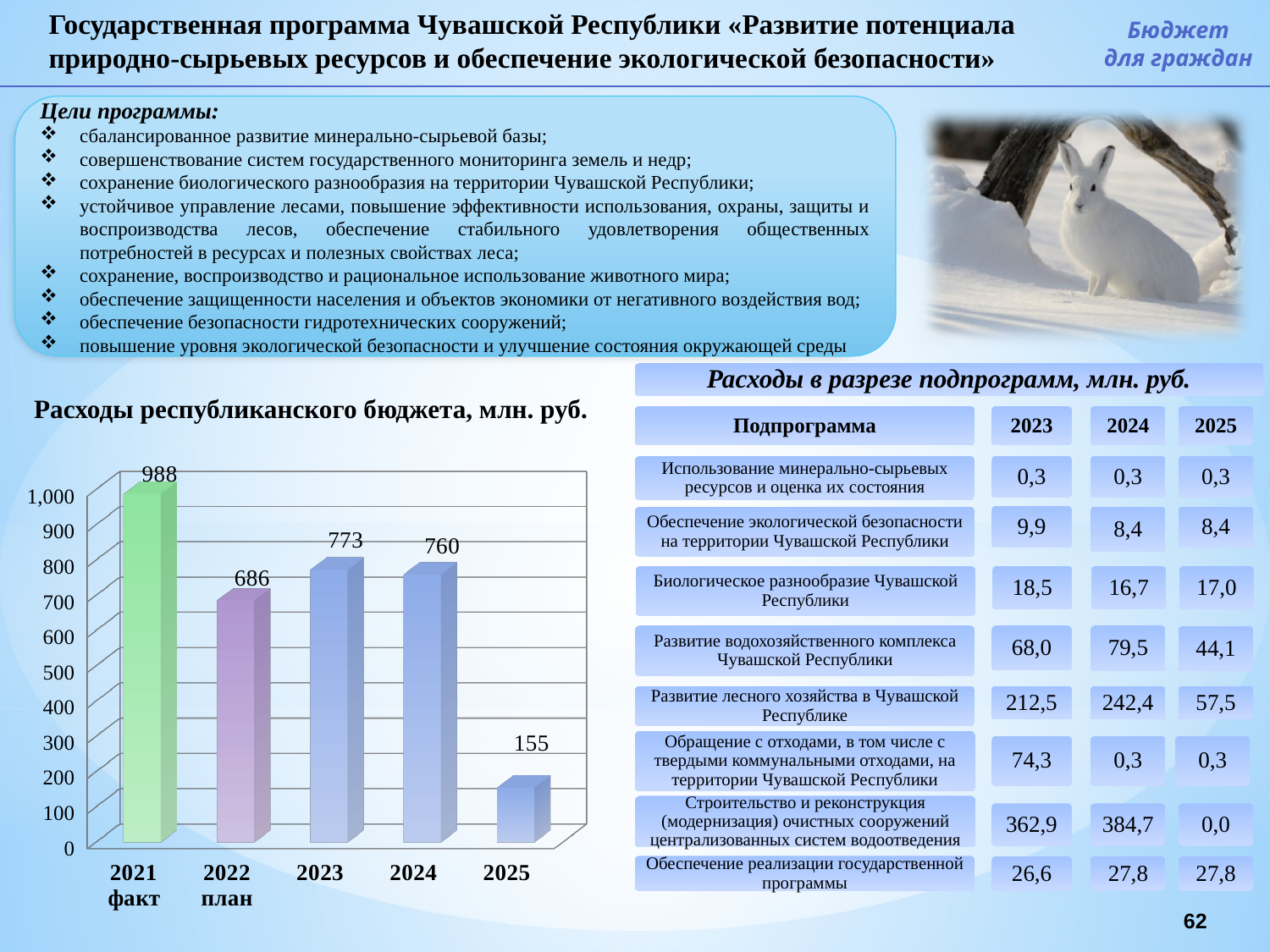
What is the difference between the values for 2023 and 2024 in the chart «Расходы республиканского бюджета, млн. руб.»? 13 What is the value for 2022 план in the chart «Расходы республиканского бюджета, млн. руб.»? 686 Which category has the highest value in the chart «Расходы республиканского бюджета, млн. руб.»? 2021 факт Which is larger in the chart «Расходы республиканского бюджета, млн. руб.»: the value for 2022 план or the value for 2023? 2023 What kind of chart is «Расходы республиканского бюджета, млн. руб.»? Bar chart How many bars are shown in the chart «Расходы республиканского бюджета, млн. руб.»? 5 What is the title of the chart on the left side of the slide? Расходы республиканского бюджета, млн. руб. What is the value for 2021 факт in the chart «Расходы республиканского бюджета, млн. руб.»? 988 What is the value for 2024 in the chart «Расходы республиканского бюджета, млн. руб.»? 760 Which category has the lowest value in the chart «Расходы республиканского бюджета, млн. руб.»? 2025 What is the value for 2025 in the chart «Расходы республиканского бюджета, млн. руб.»? 155 What is the difference between the values for 2021 факт and 2025 in the chart «Расходы республиканского бюджета, млн. руб.»? 833